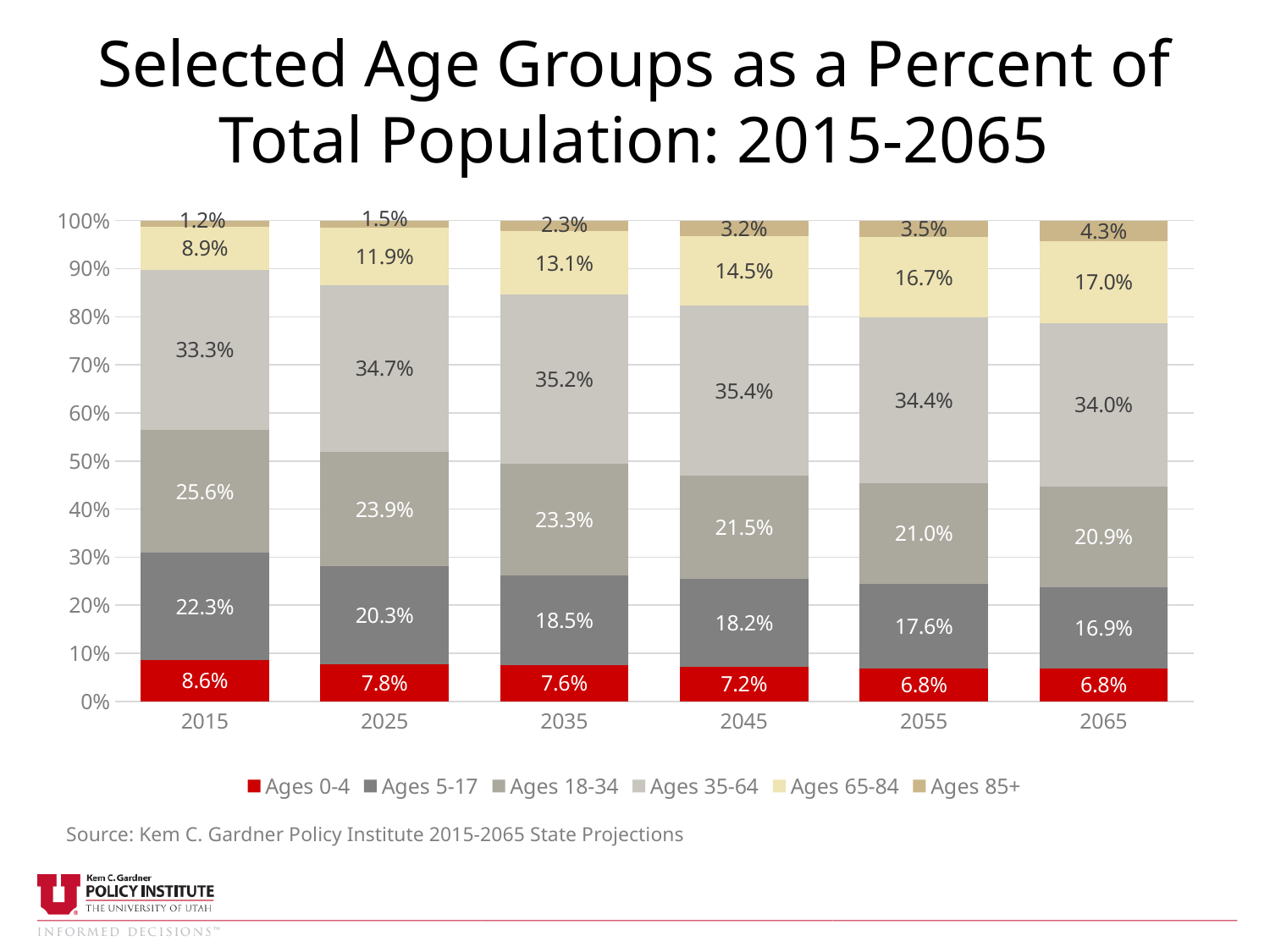
How many series does the legend list? 6 What is the value for Ages 85+ in 2035? 2.3% What is the value for Ages 65-84 in 2065? 17.0% What is the value for Ages 35-64 in 2045? 35.4% In which year is the Ages 65-84 share highest? 2065 What kind of chart is this? Stacked bar chart What is the difference between the Ages 18-34 share in 2015 and in 2065? 4.7% In which year is the Ages 5-17 share lowest? 2065 Does the Ages 0-4 share rise or fall from 2015 to 2065? Fall Which is larger: the Ages 35-64 share in 2035 or in 2055? 2035 How many years are shown on the x axis? 6 What is the value for Ages 0-4 in 2015? 8.6%